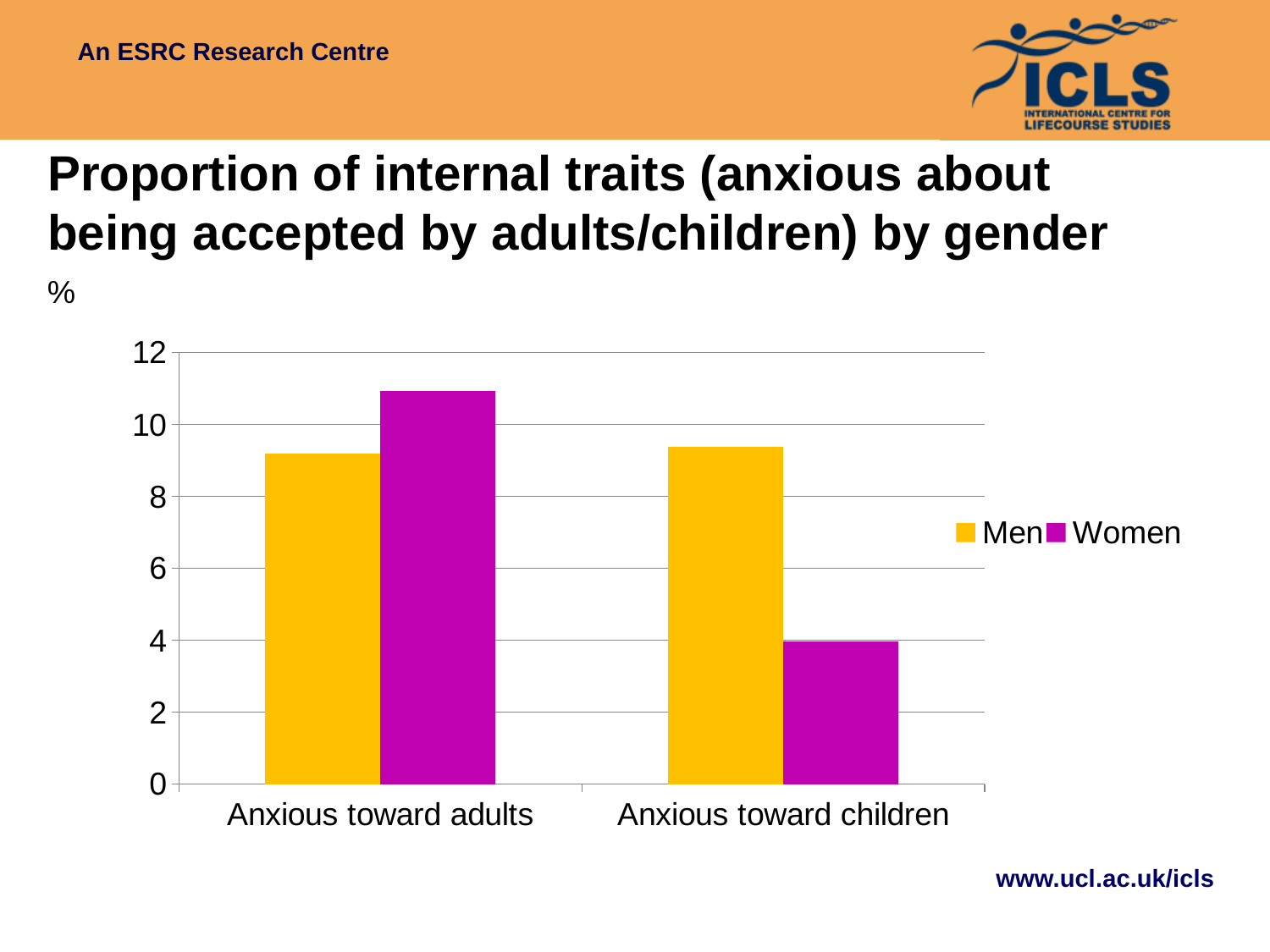
Is the value for Women in Anxious toward adults greater or less than 10? greater Which series has the higher value for Anxious toward adults, Men or Women? Women For the Women series, which category has the lowest value? Anxious toward children For the Women series, which category has the highest value? Anxious toward adults How many series does the legend list? 2 Which series has the higher value for Anxious toward children, Men or Women? Men Is the value for Men in Anxious toward children greater or less than 8? greater Is the value for Men in Anxious toward adults greater or less than 10? less What colour are the bars for the Women series? purple How many categories are shown on the x axis? 2 What kind of chart is shown on the slide? bar chart